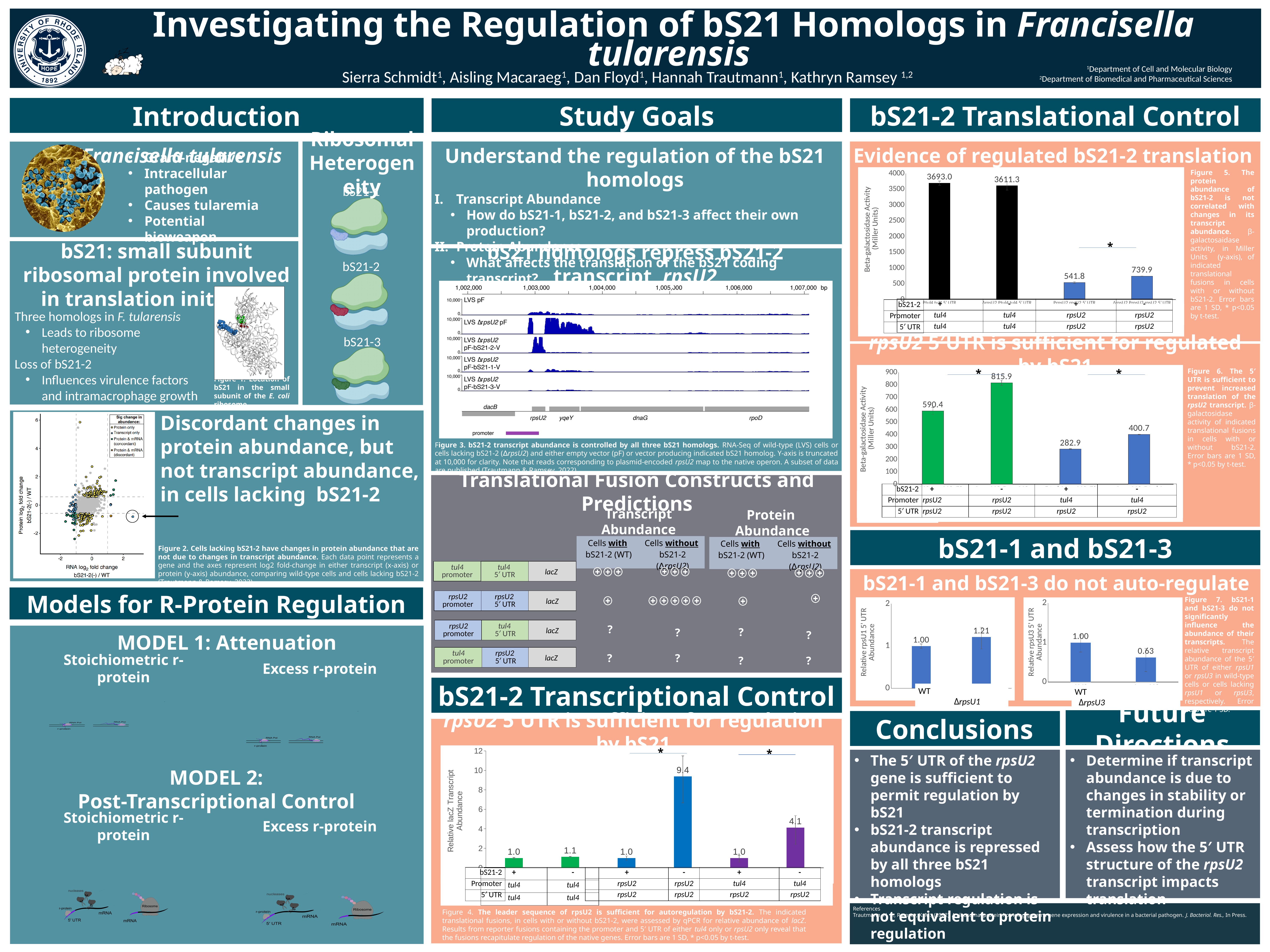
In the bS21-2 Transcriptional Control chart (Figure 4), what is the difference between the tul4 promoter / rpsU2 5' UTR bars without and with bS21-2 (4.1 minus 1.0)? 3.1 In the 'rpsU2 5'UTR is sufficient for regulated translation by bS21' chart, how many bars are plotted? 4 In the 'rpsU2 5'UTR is sufficient for regulated translation by bS21' chart, what is the difference between the two tul4 promoter bars (400.7 minus 282.9)? 117.8 In the 'rpsU2 5'UTR is sufficient for regulated translation by bS21' chart, what is the beta-galactosidase activity for the rpsU2 promoter / rpsU2 5' UTR fusion in cells without bS21-2 (-)? 815.9 In the 'Evidence of regulated bS21-2 translation' chart, what is the beta-galactosidase activity for the tul4 promoter / tul4 5' UTR fusion in cells with bS21-2 (+)? 3693.0 In the bS21-2 Transcriptional Control chart (Figure 4), what is the relative lacZ transcript abundance for the rpsU2 promoter / rpsU2 5' UTR fusion in cells without bS21-2 (-)? 9.4 In the 'Evidence of regulated bS21-2 translation' chart, which fusion has the lowest beta-galactosidase activity? rpsU2 promoter / rpsU2 5' UTR with bS21-2 (+), 541.8 In the 'rpsU2 5'UTR is sufficient for regulated translation by bS21' chart, which bar is the lowest? tul4 promoter / rpsU2 5' UTR with bS21-2 (+), 282.9 In the 'Evidence of regulated bS21-2 translation' chart, what is the beta-galactosidase activity for the rpsU2 promoter / rpsU2 5' UTR fusion in cells without bS21-2 (-)? 739.9 In the Figure 7 chart on the right (Relative rpsU3 5' UTR Abundance), what is the value for ΔrpsU3? 0.63 In the 'Evidence of regulated bS21-2 translation' chart, what is the difference between the two rpsU2 promoter bars (without minus with bS21-2)? 198.1 In the bS21-2 Transcriptional Control chart (Figure 4), which fusion has the highest relative lacZ transcript abundance? rpsU2 promoter / rpsU2 5' UTR without bS21-2 (-), 9.4